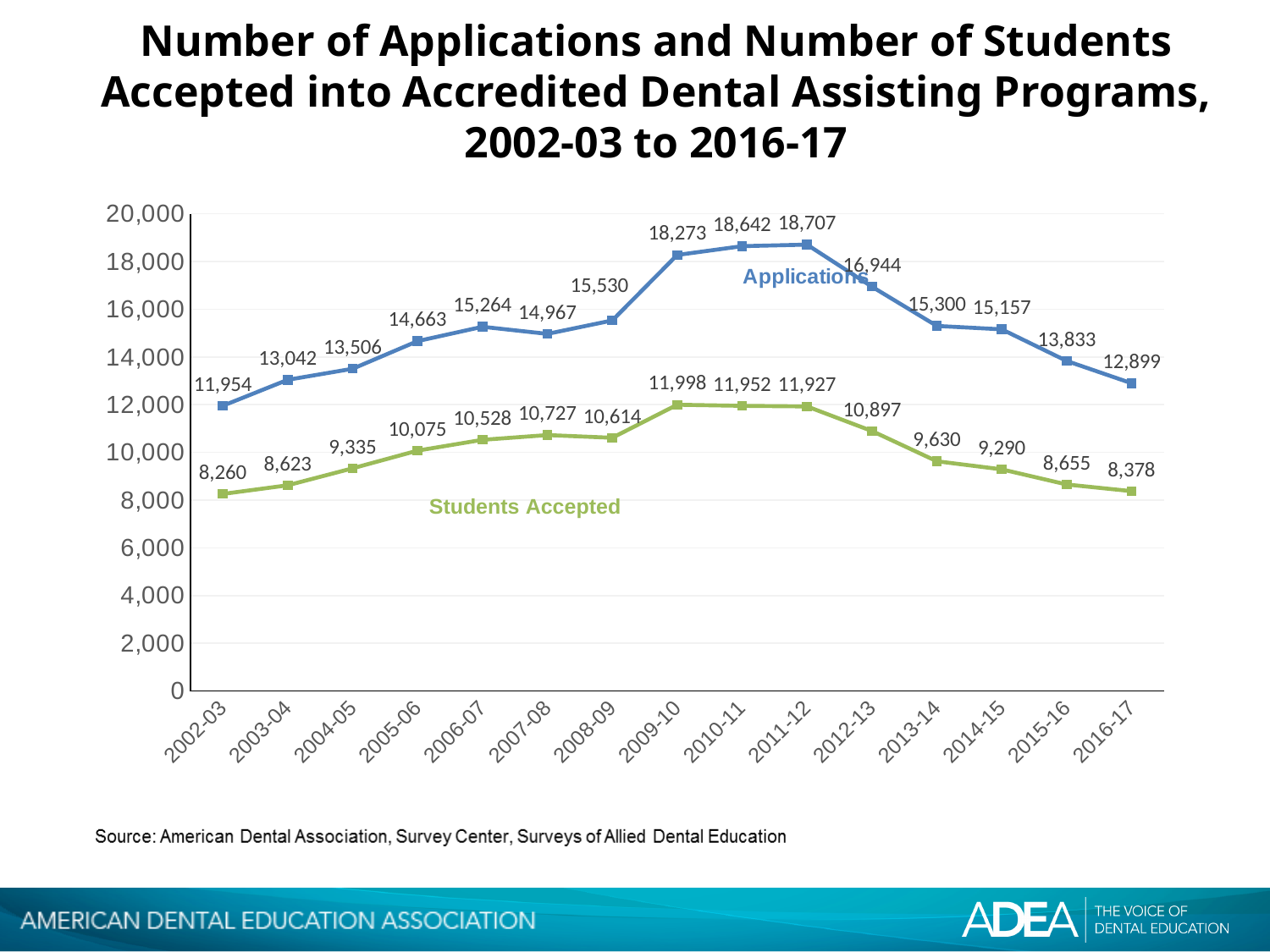
How many academic years are shown on the x axis? 15 How did the number of Students Accepted change from 2011-12 to 2016-17? It fell What kind of chart is shown on the slide? Line chart In which year was the number of Applications highest? 2011-12 How many data series are plotted on the chart? 2 In which year was the number of Students Accepted lowest? 2002-03 What was the number of Students Accepted in 2016-17? 8,378 What is the difference between Applications and Students Accepted in 2011-12? 6,780 Which is larger: Applications in 2003-04 or Applications in 2016-17? Applications in 2003-04 What colour is the Students Accepted line? Green Is the number of Applications in 2012-13 greater or less than 16,000? greater What was the number of Applications in 2009-10? 18,273